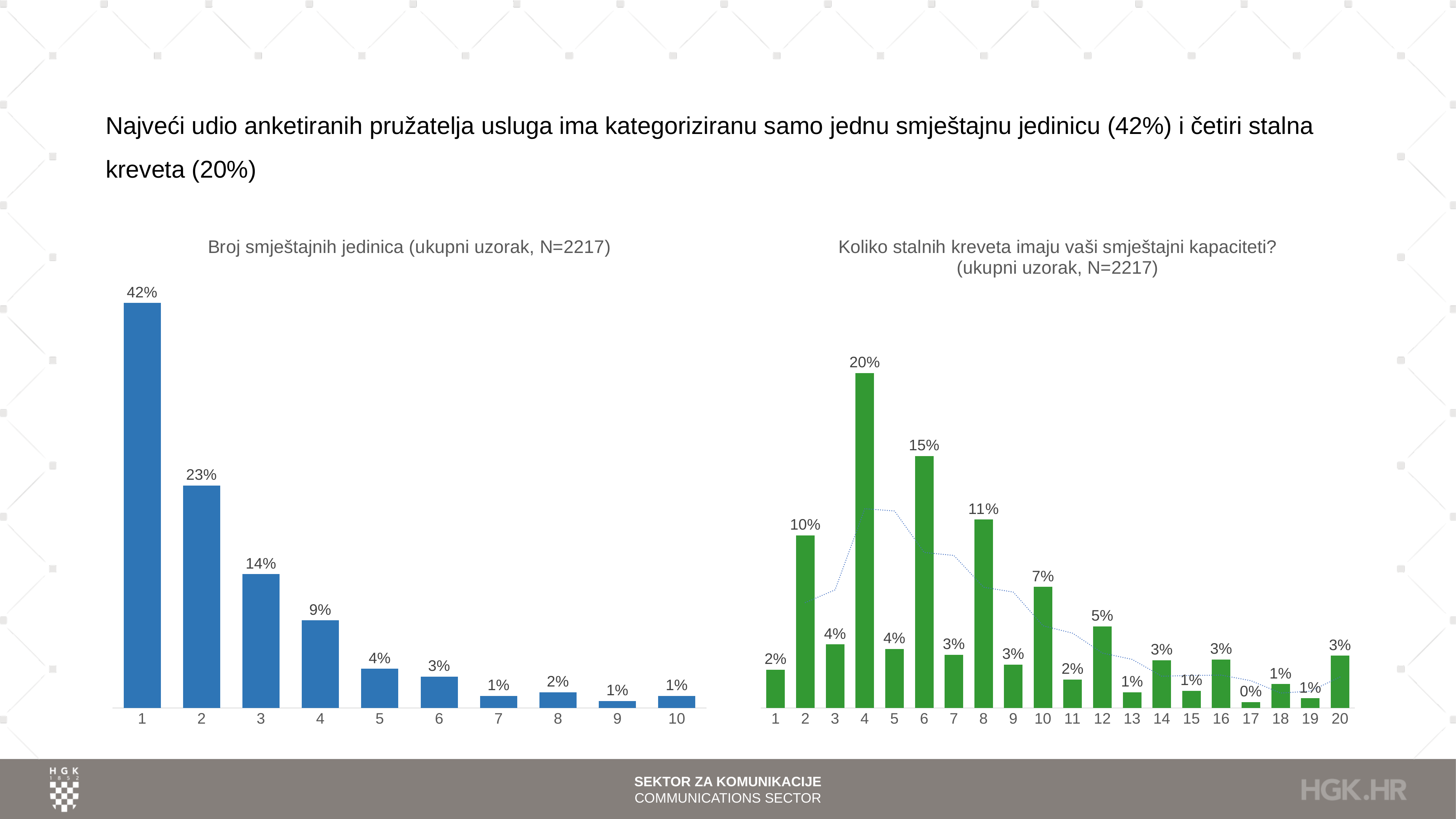
In the chart titled "Koliko stalnih kreveta imaju vaši smještajni kapaciteti?", which category has the lowest value? 17 In the chart titled "Koliko stalnih kreveta imaju vaši smještajni kapaciteti?", how many categories are shown on the x axis? 20 In the chart titled "Broj smještajnih jedinica (ukupni uzorak, N=2217)", how many categories are shown on the x axis? 10 In the chart titled "Koliko stalnih kreveta imaju vaši smještajni kapaciteti?", what is the value for category 4? 20% In the chart titled "Broj smještajnih jedinica (ukupni uzorak, N=2217)", what is the difference between the values for categories 1 and 2? 19% In the chart titled "Broj smještajnih jedinica (ukupni uzorak, N=2217)", what is the value for category 1? 42% In the chart titled "Broj smještajnih jedinica (ukupni uzorak, N=2217)", which category has the highest value? 1 In the chart titled "Koliko stalnih kreveta imaju vaši smještajni kapaciteti?", which is larger, the value for category 6 or the value for category 10? 6 In the chart titled "Broj smještajnih jedinica (ukupni uzorak, N=2217)", what is the value for category 3? 14% In the chart titled "Koliko stalnih kreveta imaju vaši smještajni kapaciteti?", which category has the highest value? 4 In the chart titled "Koliko stalnih kreveta imaju vaši smještajni kapaciteti?", what is the value for category 8? 11% In the chart titled "Broj smještajnih jedinica (ukupni uzorak, N=2217)", do the values generally rise or fall from category 1 to category 6? fall